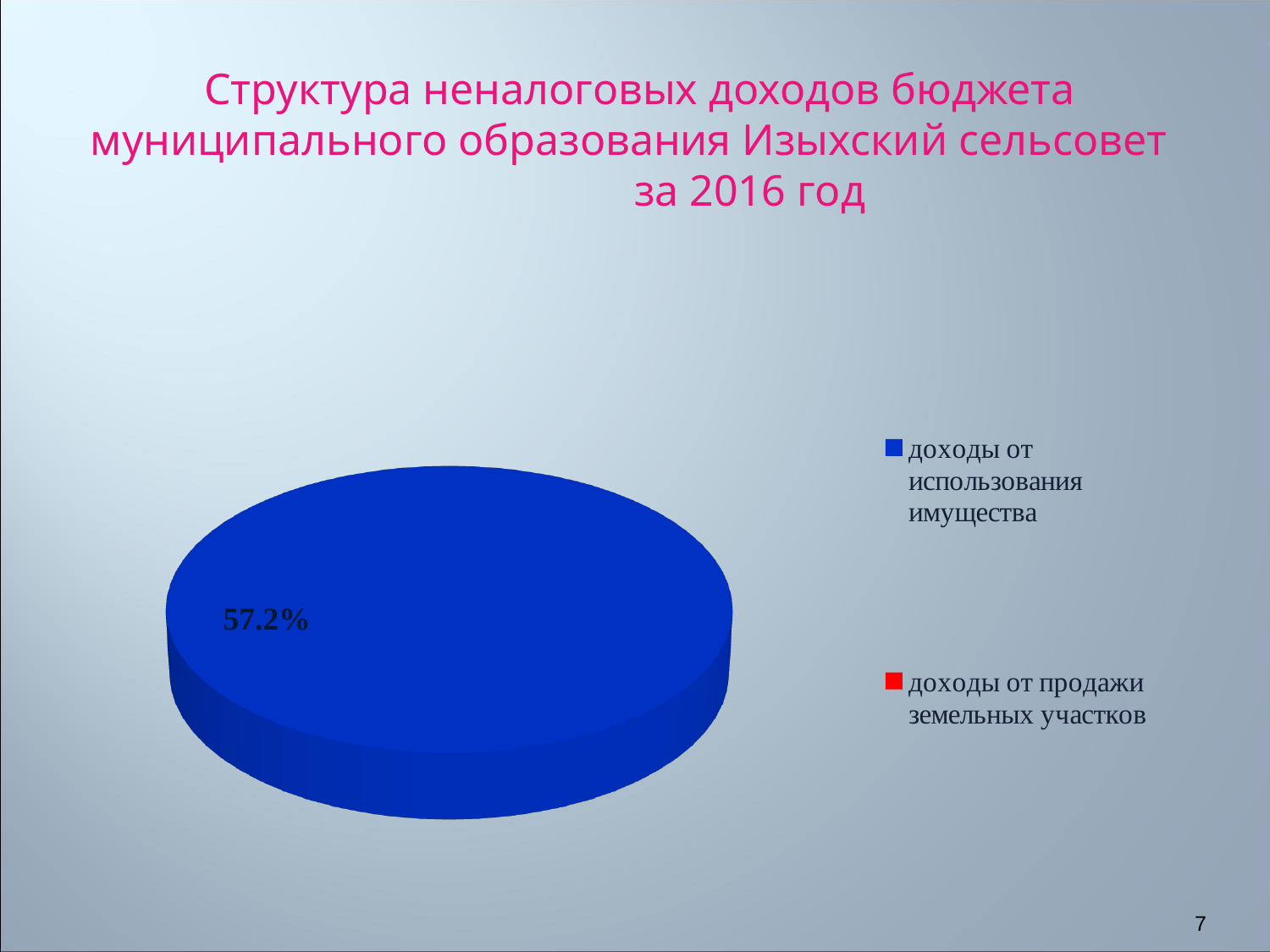
What percentage is printed on the blue slice of the pie chart? 57.2% What share of the pie is labelled for 'доходы от использования имущества'? 57.2% Which category has the larger share of the pie, 'доходы от использования имущества' or 'доходы от продажи земельных участков'? доходы от использования имущества How many entries does the legend of the pie chart list? 2 What colour does the legend assign to 'доходы от продажи земельных участков'? red What colour does the legend assign to 'доходы от использования имущества'? blue Is the share for 'доходы от использования имущества' greater or less than 50%? greater What kind of chart is shown on the slide? pie chart How many categories are listed in the legend of the pie chart? 2